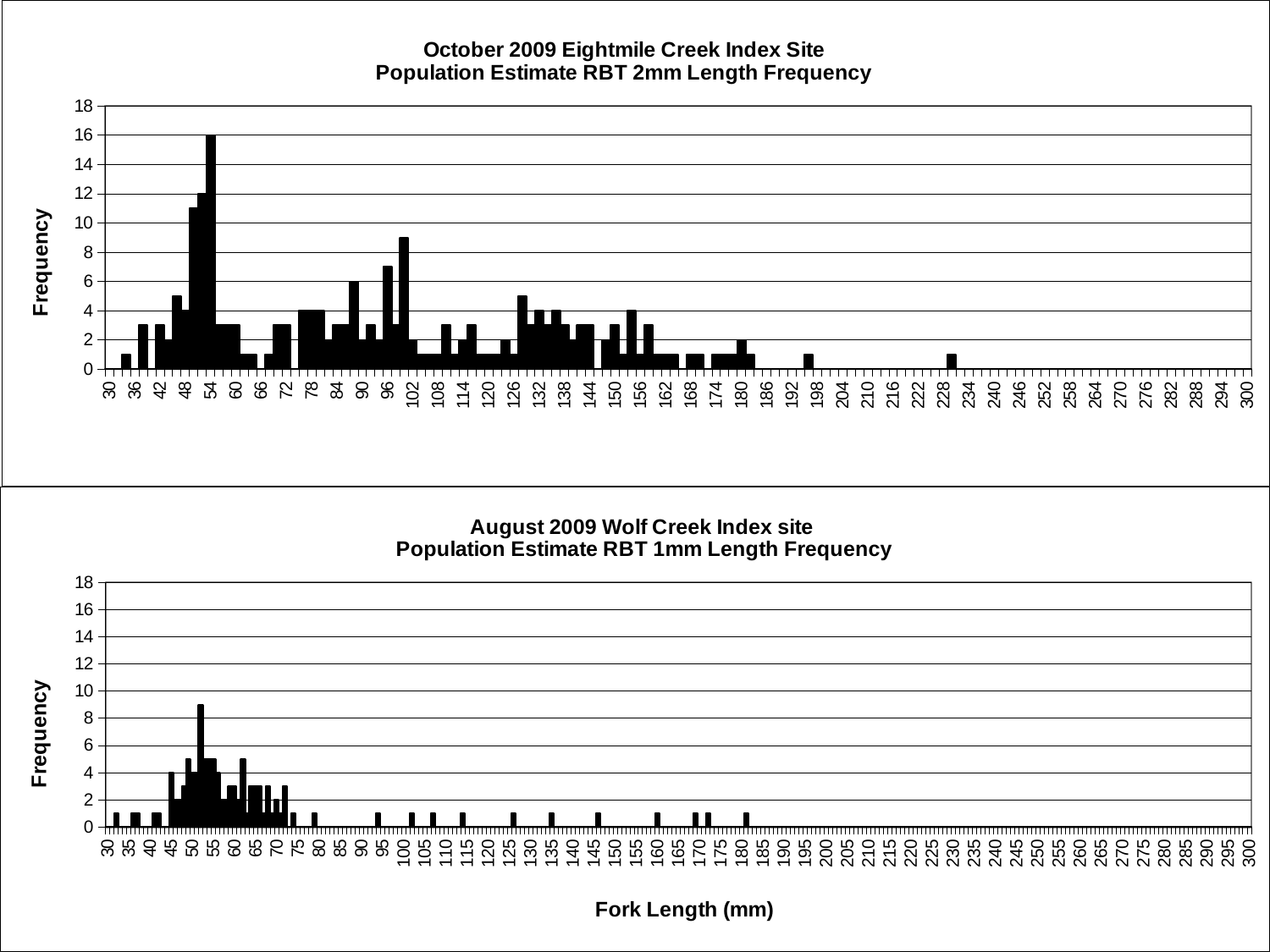
What is the x-axis label shown below the bottom chart (August 2009 Wolf Creek)? Fork Length (mm) In the bottom chart (August 2009 Wolf Creek), is the frequency at 180 mm greater or less than 2? less What kind of chart is the bottom chart, August 2009 Wolf Creek Index site? bar chart Which chart has the higher peak frequency, the October 2009 Eightmile Creek chart or the August 2009 Wolf Creek chart? October 2009 Eightmile Creek What is the highest tick value shown on the y axis of the top chart (October 2009 Eightmile Creek)? 18 In the bottom chart (August 2009 Wolf Creek), is the frequency of the tallest bar greater or less than 10? less In the top chart (October 2009 Eightmile Creek), what is the frequency of the tallest bar? 16 In the top chart (October 2009 Eightmile Creek), which fork length has the highest frequency? 54 mm What kind of chart is the top chart, October 2009 Eightmile Creek Index Site? bar chart